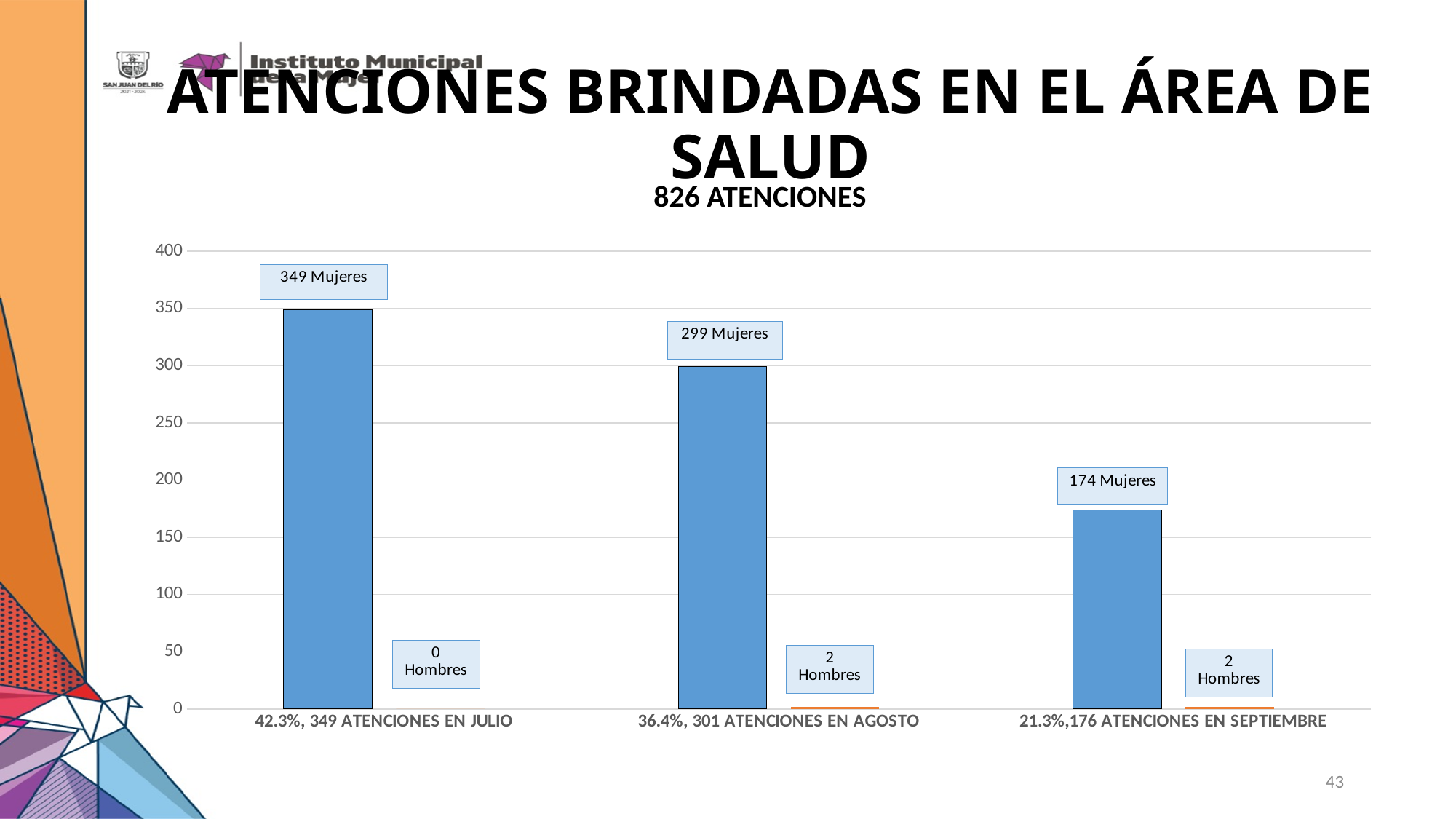
What percentage of the total atenciones corresponds to Agosto, as shown on the x-axis label? 36.4% How many Hombres were attended in Julio according to the chart? 0 Hombres Do the Mujeres values rise or fall from Julio to Septiembre? fall How many Mujeres were attended in Julio according to the chart? 349 Mujeres What is the title of the chart? 826 ATENCIONES Which month has the lowest number of Mujeres attended? Septiembre How many Hombres were attended in Septiembre according to the chart? 2 Hombres Which month has the highest number of Mujeres attended? Julio How many months (categories) are shown on the x axis of the chart? 3 What kind of chart is shown on the slide? bar chart What is the difference between the number of Mujeres attended in Julio and in Septiembre? 175 How many Mujeres were attended in Agosto according to the chart? 299 Mujeres